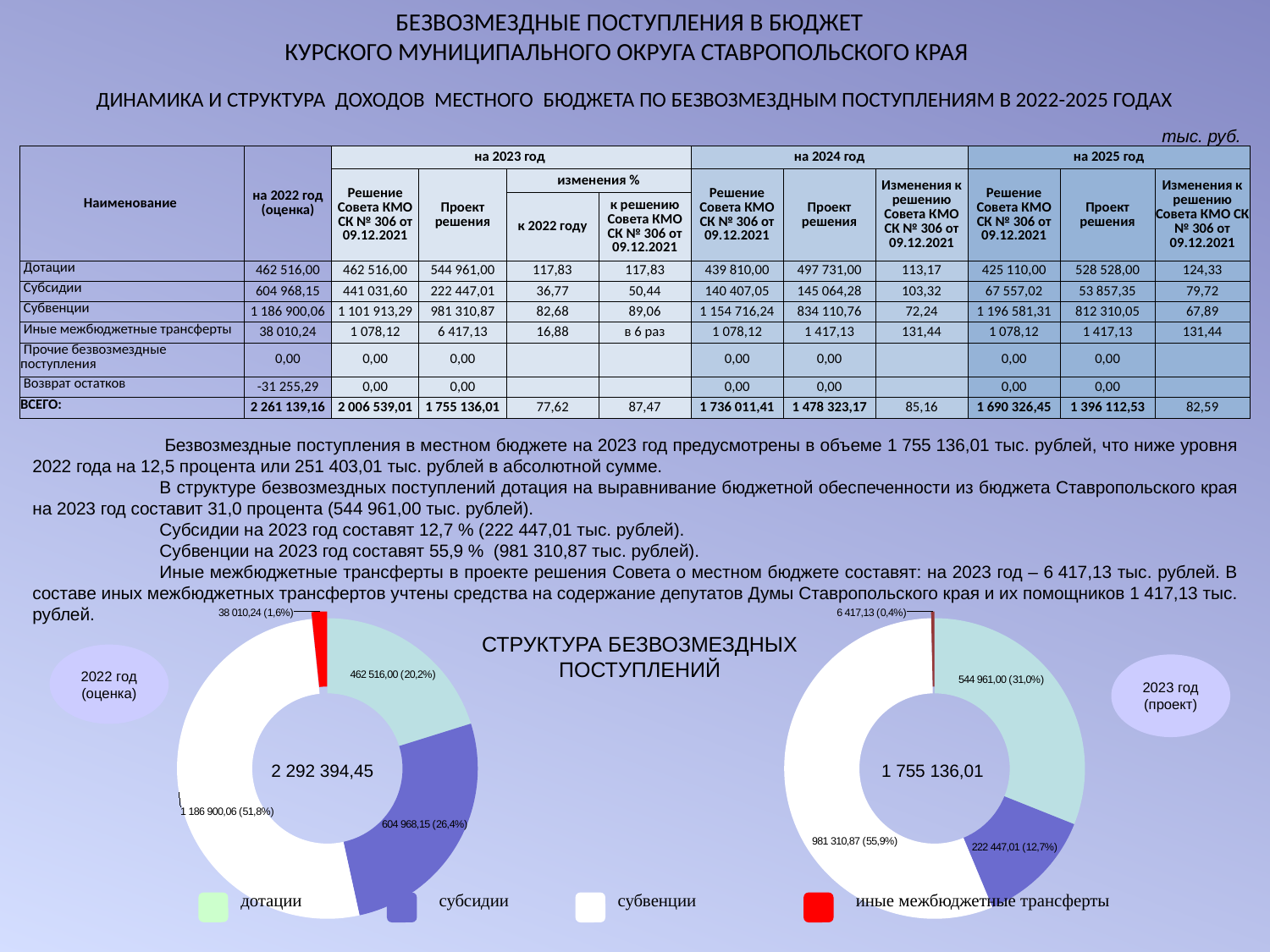
На диаграмме «2022 год (оценка)» какая категория имеет наименьшее значение? иные межбюджетные трансферты Какое общее значение указано в центре диаграммы «2023 год (проект)»? 1 755 136,01 На диаграмме «2023 год (проект)» какое значение указано для дотаций? 544 961,00 На диаграмме «2022 год (оценка)» какую долю составляют иные межбюджетные трансферты? 1,6% На диаграмме «2023 год (проект)» какую долю составляют субсидии? 12,7% На диаграмме «2023 год (проект)» какая категория имеет наибольшее значение? субвенции Сколько категорий перечислено в легенде диаграмм? 4 На диаграмме «2023 год (проект)» что больше: дотации или субсидии? дотации На диаграмме «2022 год (оценка)» что больше: дотации или субсидии? субсидии На диаграмме «2023 год (проект)» на сколько субвенции больше дотаций? 436 349,87 Какого типа диаграммы показаны на слайде? круговые (кольцевые) диаграммы На диаграмме «2022 год (оценка)» какое значение указано для субвенций? 1 186 900,06